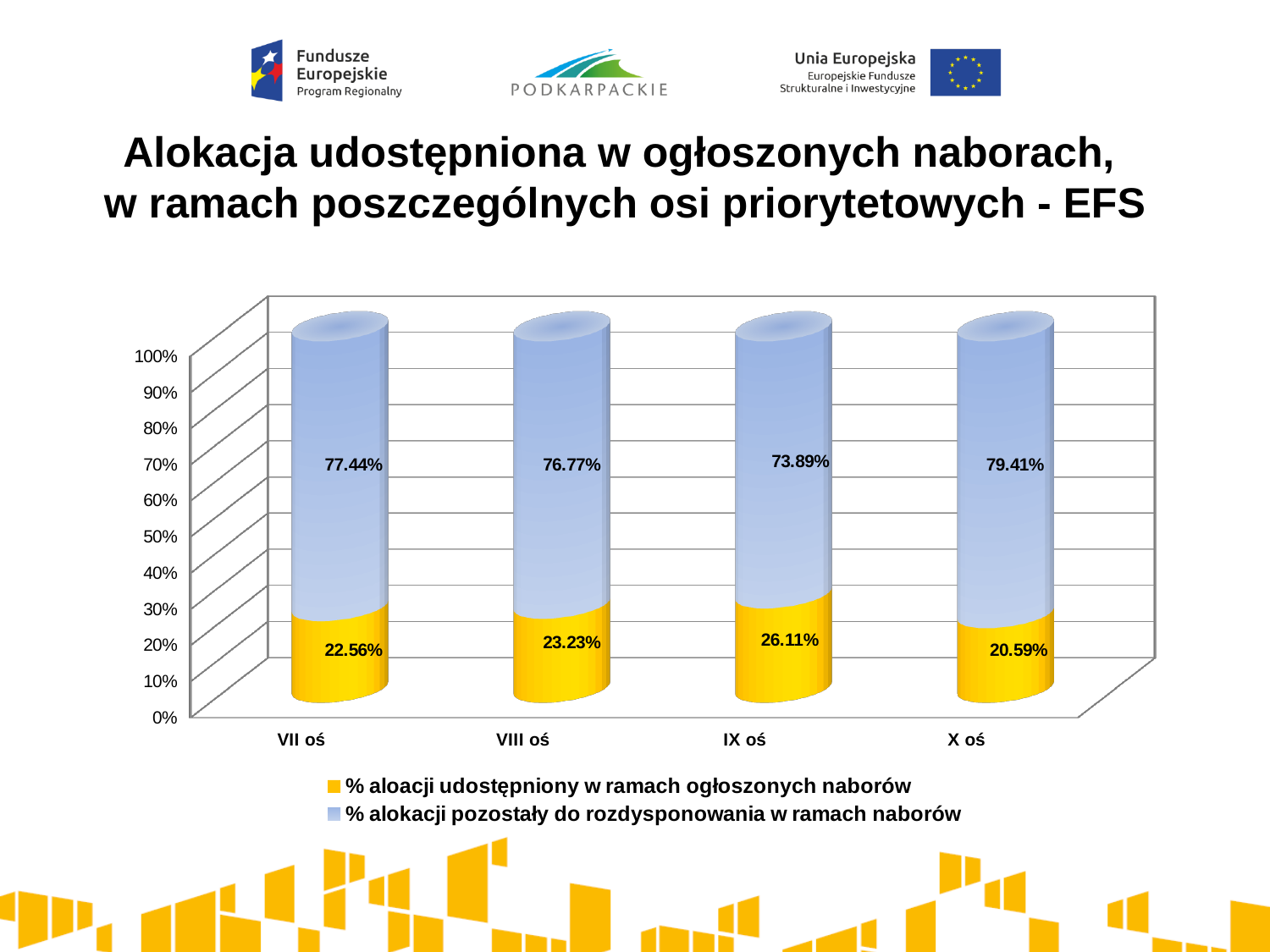
What is the difference between the "% aloacji udostępniony w ramach ogłoszonych naborów" values for IX oś and X oś? 5.52% What kind of chart is shown on the slide? Stacked bar chart What is the value of "% alokacji pozostały do rozdysponowania w ramach naborów" for VIII oś? 76.77% Which category has the lowest value of "% aloacji udostępniony w ramach ogłoszonych naborów"? X oś What is the total of the stacked bar for VIII oś? 100% What is the value of "% aloacji udostępniony w ramach ogłoszonych naborów" for IX oś? 26.11% What is the value of "% aloacji udostępniony w ramach ogłoszonych naborów" for VII oś? 22.56% Which category has the highest value of "% aloacji udostępniony w ramach ogłoszonych naborów"? IX oś How many series does the chart legend list? 2 Which is larger: the "% alokacji pozostały do rozdysponowania w ramach naborów" value for VII oś or for IX oś? VII oś What is the value of "% alokacji pozostały do rozdysponowania w ramach naborów" for X oś? 79.41% How many categories are shown on the x axis of the chart? 4